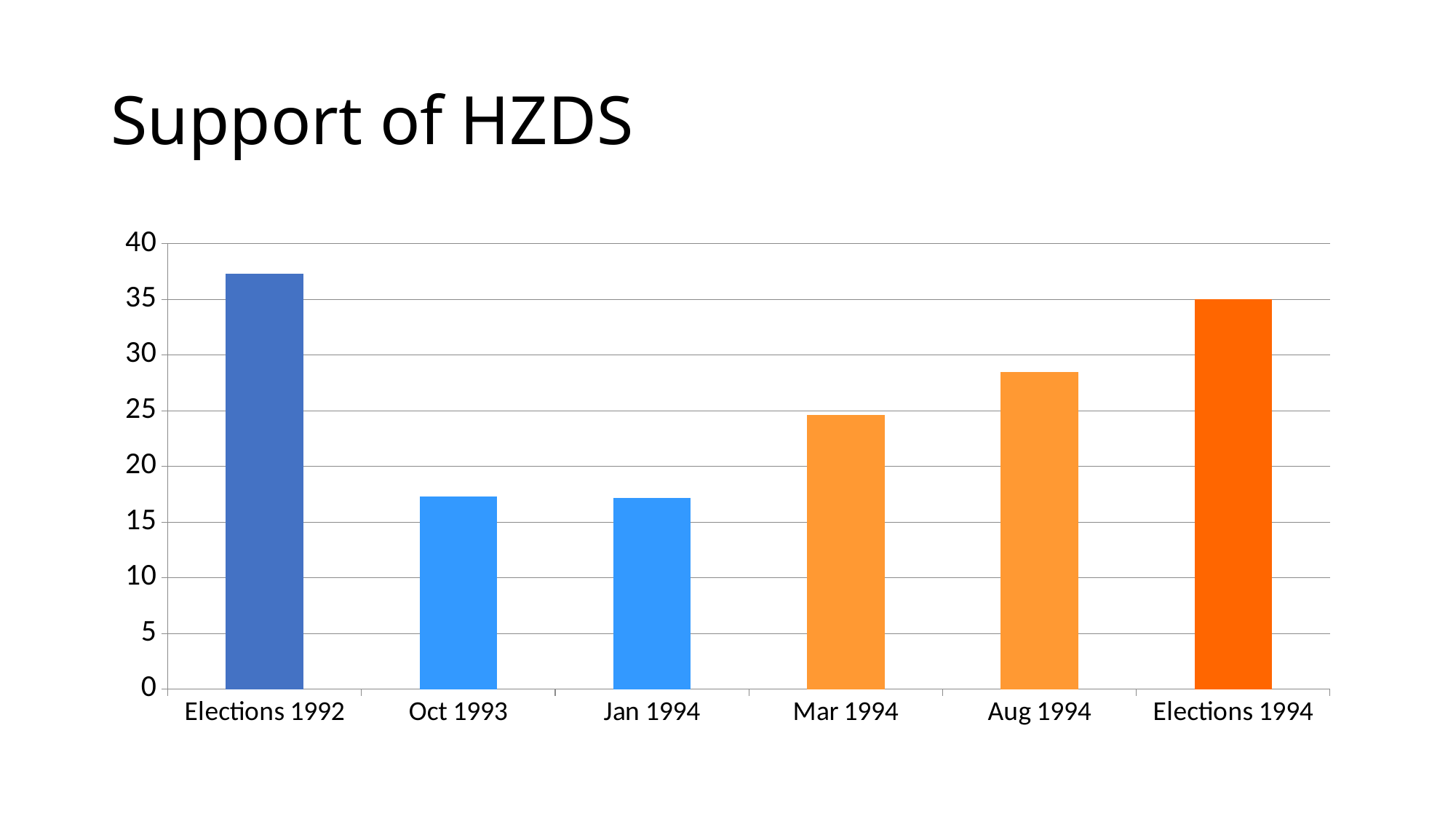
Is the value for Oct 1993 greater or less than 20? less Which is larger, the value for Aug 1994 or the value for Mar 1994? Aug 1994 Do the values rise or fall from Oct 1993 to Elections 1994? rise Is the value for Elections 1994 greater or less than 30? greater Which category has the highest value? Elections 1992 Is the value for Elections 1992 greater or less than 35? greater What type of chart is shown on the slide? bar chart How many categories are shown on the x axis? 6 What is the title of the chart? Support of HZDS